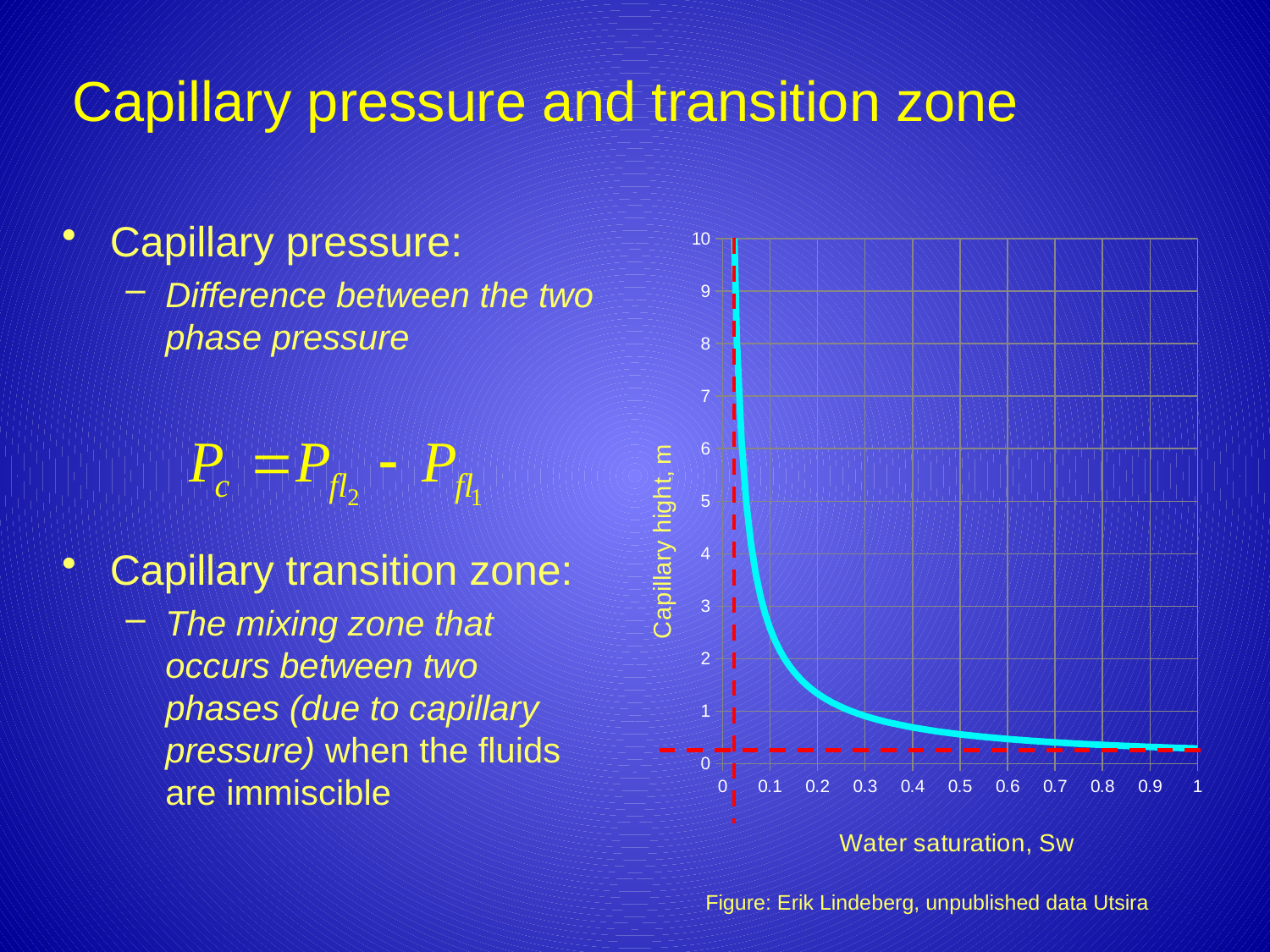
What is the title of the x axis of the chart? Water saturation, Sw Is the capillary height at a water saturation of 0.8 greater or less than 2? less Is the capillary height at a water saturation of 0.5 greater or less than 1? less What kind of chart is shown on the slide? line chart What is the highest value shown on the y axis of the chart? 10 How many tick labels are shown on the x axis of the chart? 11 Is the capillary height at a water saturation of 0.1 greater or less than 1? greater Which has the larger capillary height: a water saturation of 0.1 or 0.5? 0.1 Does the capillary height rise or fall as water saturation increases along the x axis? fall What is the title of the y axis of the chart? Capillary hight, m